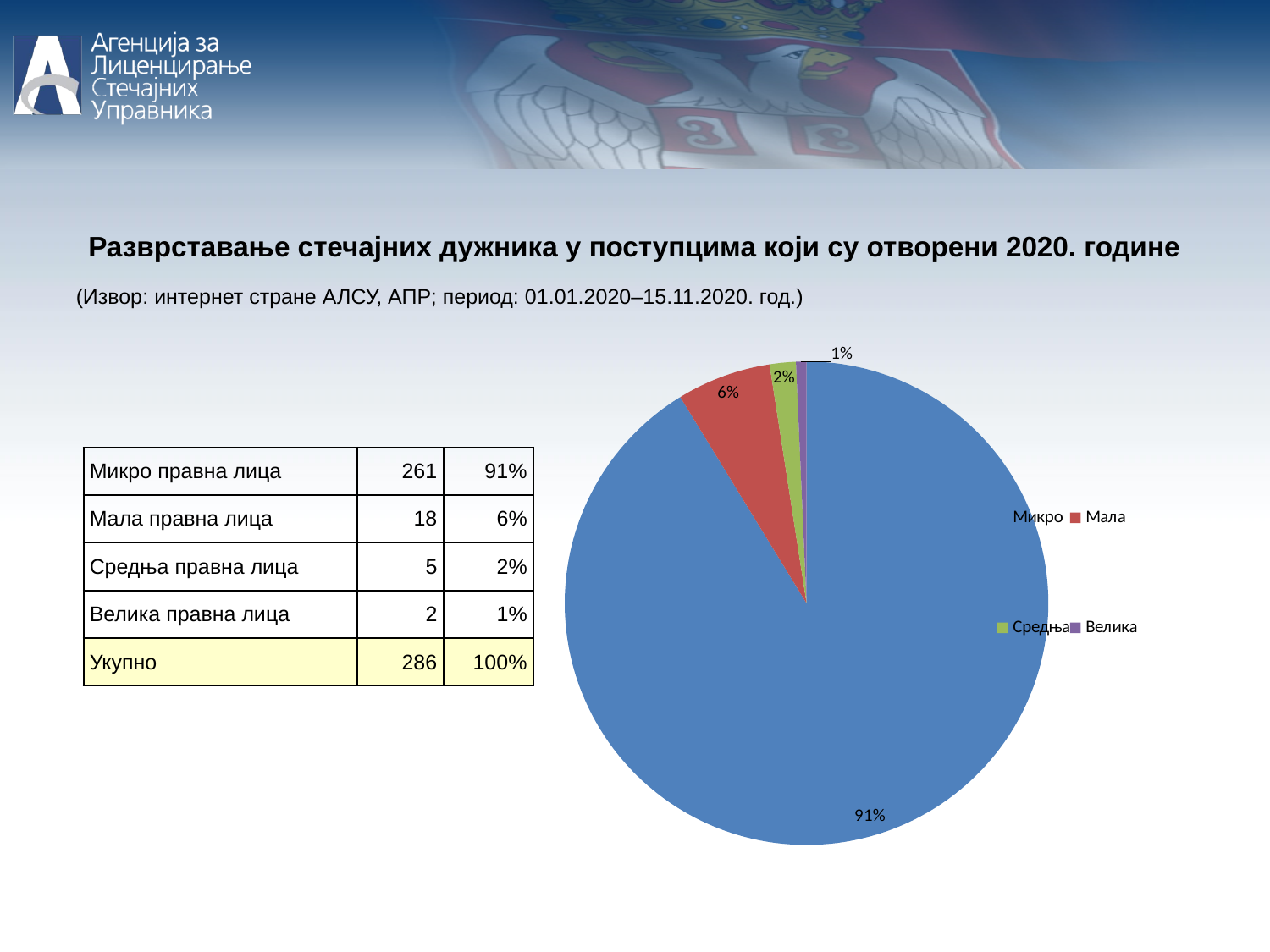
Which category has the smallest slice of the pie? Велика What share of the pie does the Средња slice represent? 2% What kind of chart is shown on the slide? pie chart Which slice is larger, Мала or Средња? Мала How many entries does the legend of the pie chart list? 4 How many slices does the pie chart have? 4 What is the difference in percentage points between the Микро slice and the Мала slice? 85% Which category has the largest slice of the pie? Микро What colour is the Микро slice in the pie chart? blue What share of the pie does the Микро slice represent? 91% What share of the pie does the Велика slice represent? 1%